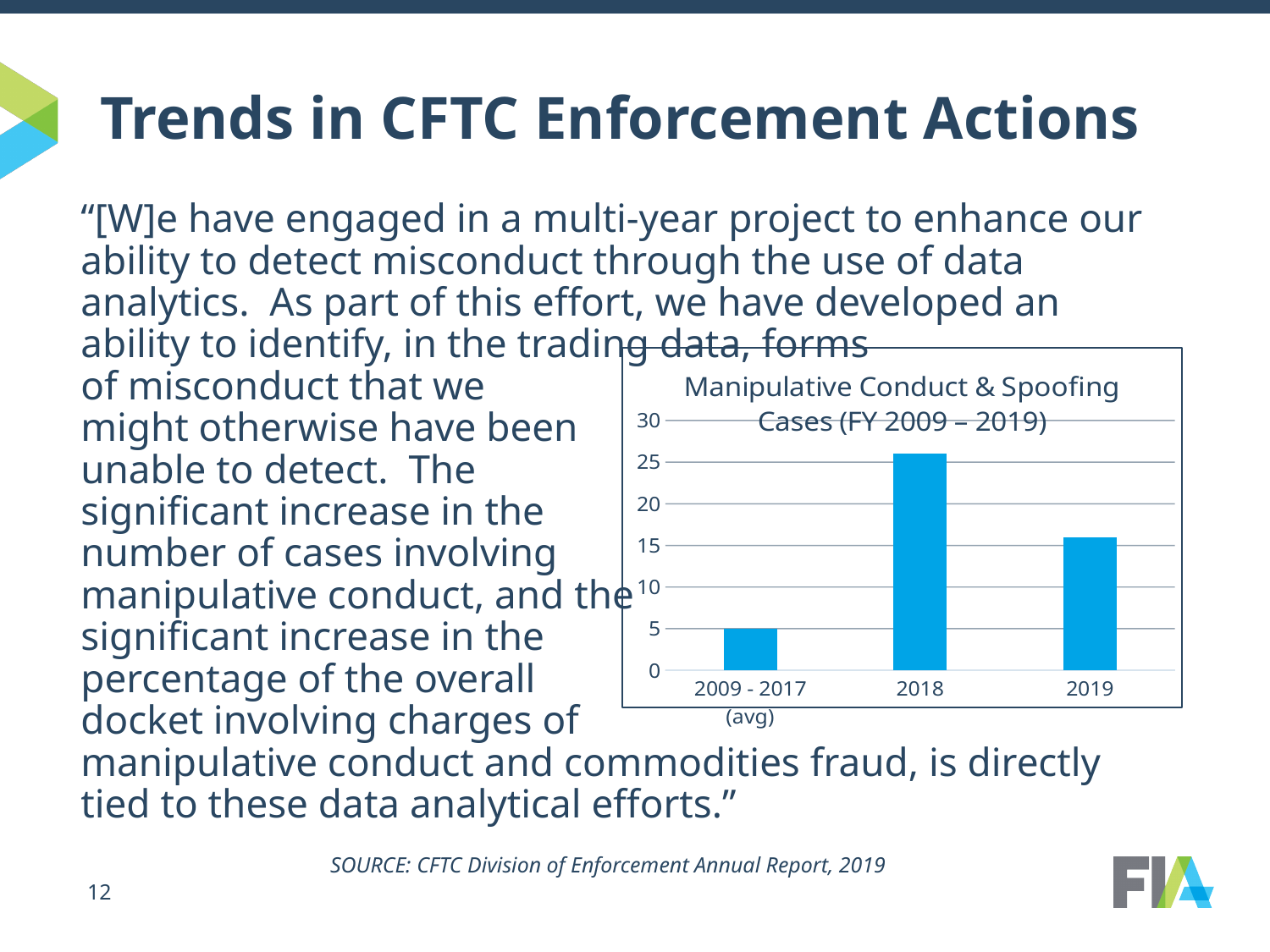
Is the value for 2018 greater or less than 25? greater Is the value for 2009 - 2017 (avg) greater or less than 10? less What is the highest value shown on the chart's vertical axis? 30 Which category has the highest value in the chart? 2018 Which category has the lowest value in the chart? 2009 - 2017 (avg) Is the value for 2019 greater or less than 20? less Does the value rise or fall from 2018 to 2019? fall What is the title of the chart? Manipulative Conduct & Spoofing Cases (FY 2009 – 2019) How many categories are shown on the x axis of the chart? 3 What kind of chart is shown on the slide? bar chart Which is larger, the value for 2018 or the value for 2019? 2018